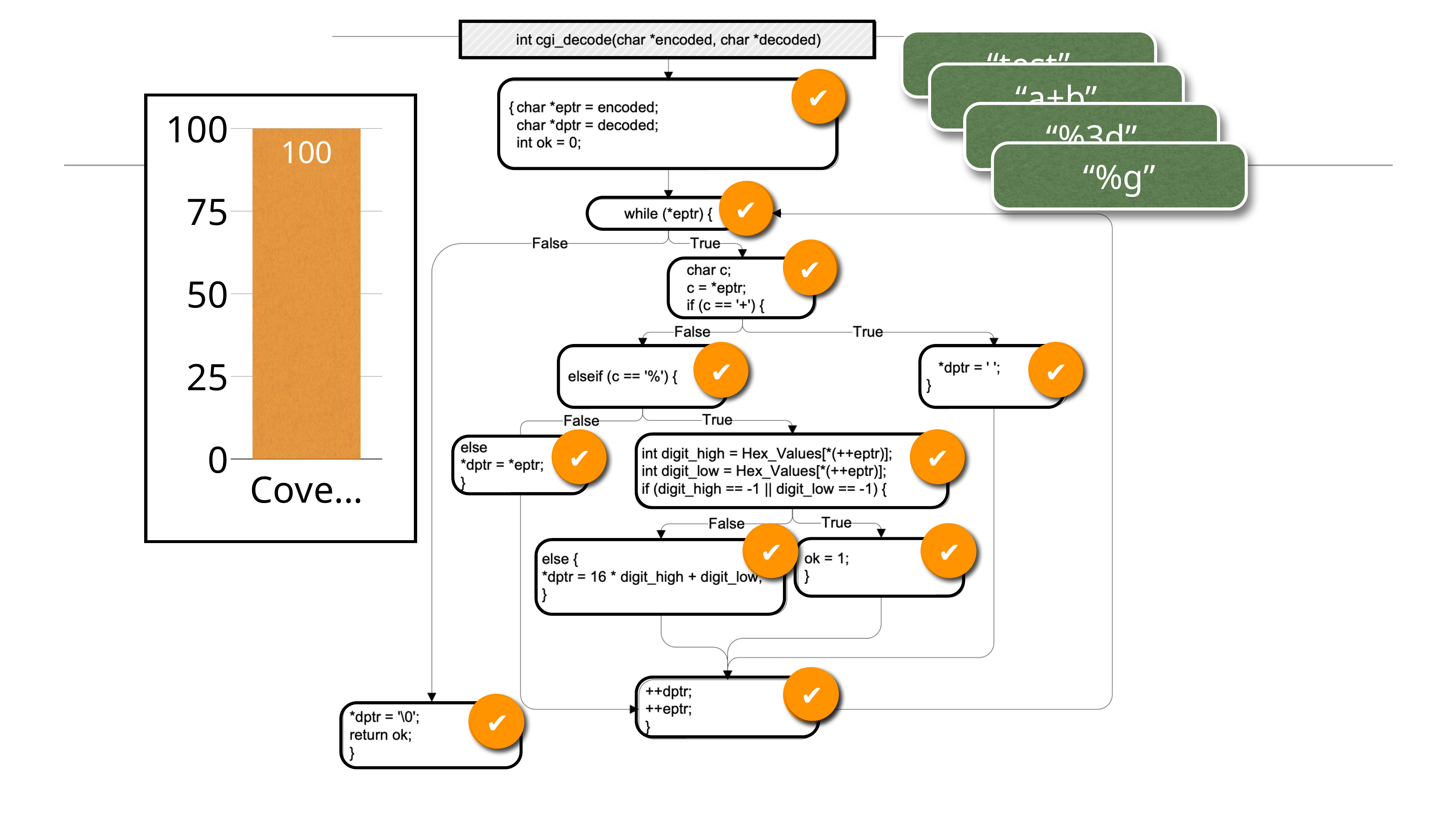
How many bars does the chart show? 1 What value is printed on the bar in the chart? 100 Is the value of the bar in the chart greater or less than 75? greater What is the highest tick value shown on the chart's vertical axis? 100 Is the value of the bar in the chart greater or less than 50? greater What kind of chart is shown on the left of the slide? bar chart What colour is the bar in the chart? orange